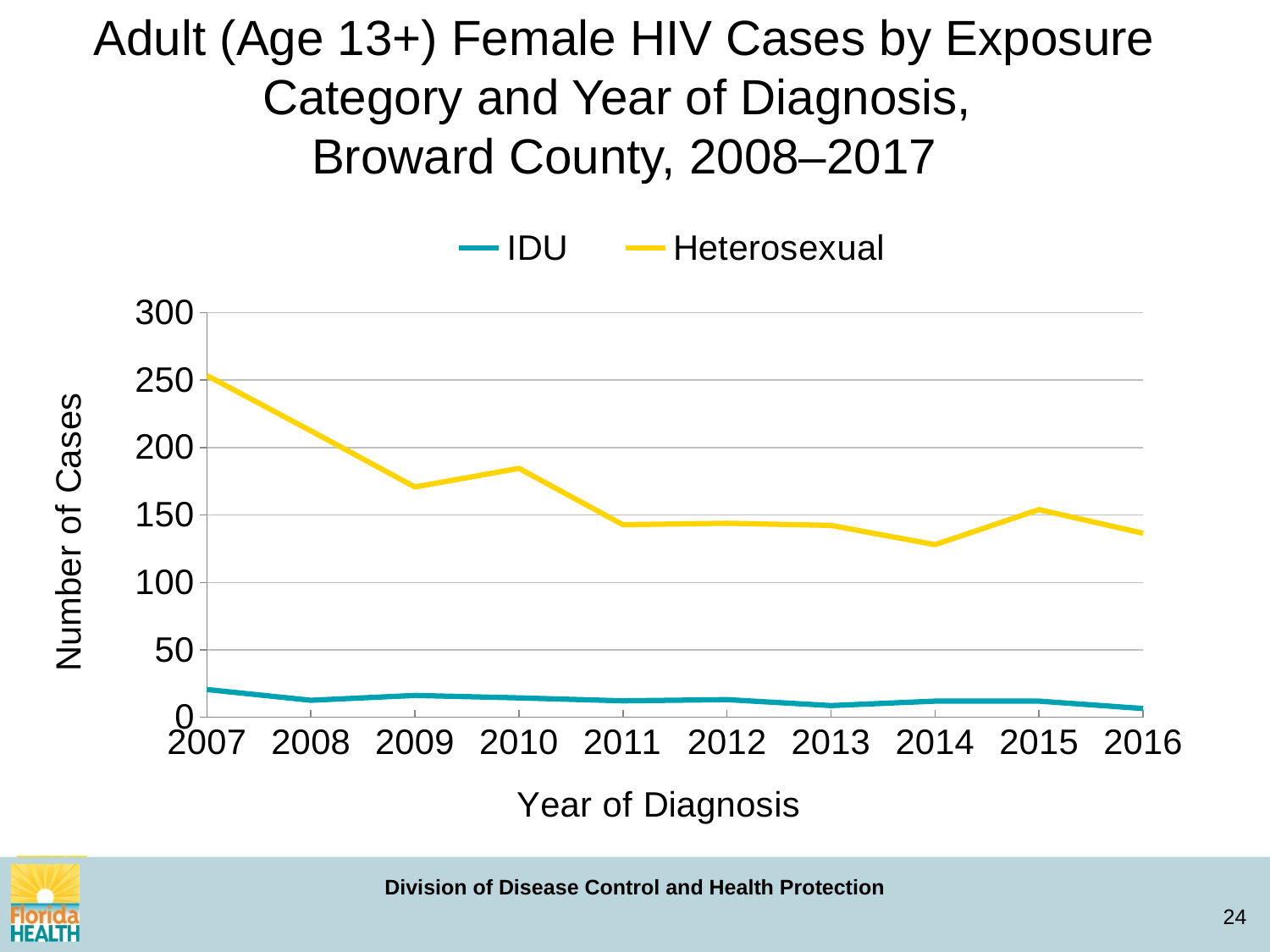
In which year is the IDU series highest? 2007 Is the Heterosexual value for 2007 greater or less than 200? greater Is the Heterosexual value for 2009 greater or less than 200? less Is the Heterosexual value for 2014 greater or less than 150? less Overall, does the Heterosexual series rise or fall from 2007 to 2016? fall In which year is the Heterosexual series highest? 2007 Which is larger for the Heterosexual series, the value for 2008 or the value for 2009? 2008 How many series does the legend list? 2 What kind of chart is shown on the slide? line chart What is the label on the vertical axis? Number of Cases How many years are shown on the x axis? 10